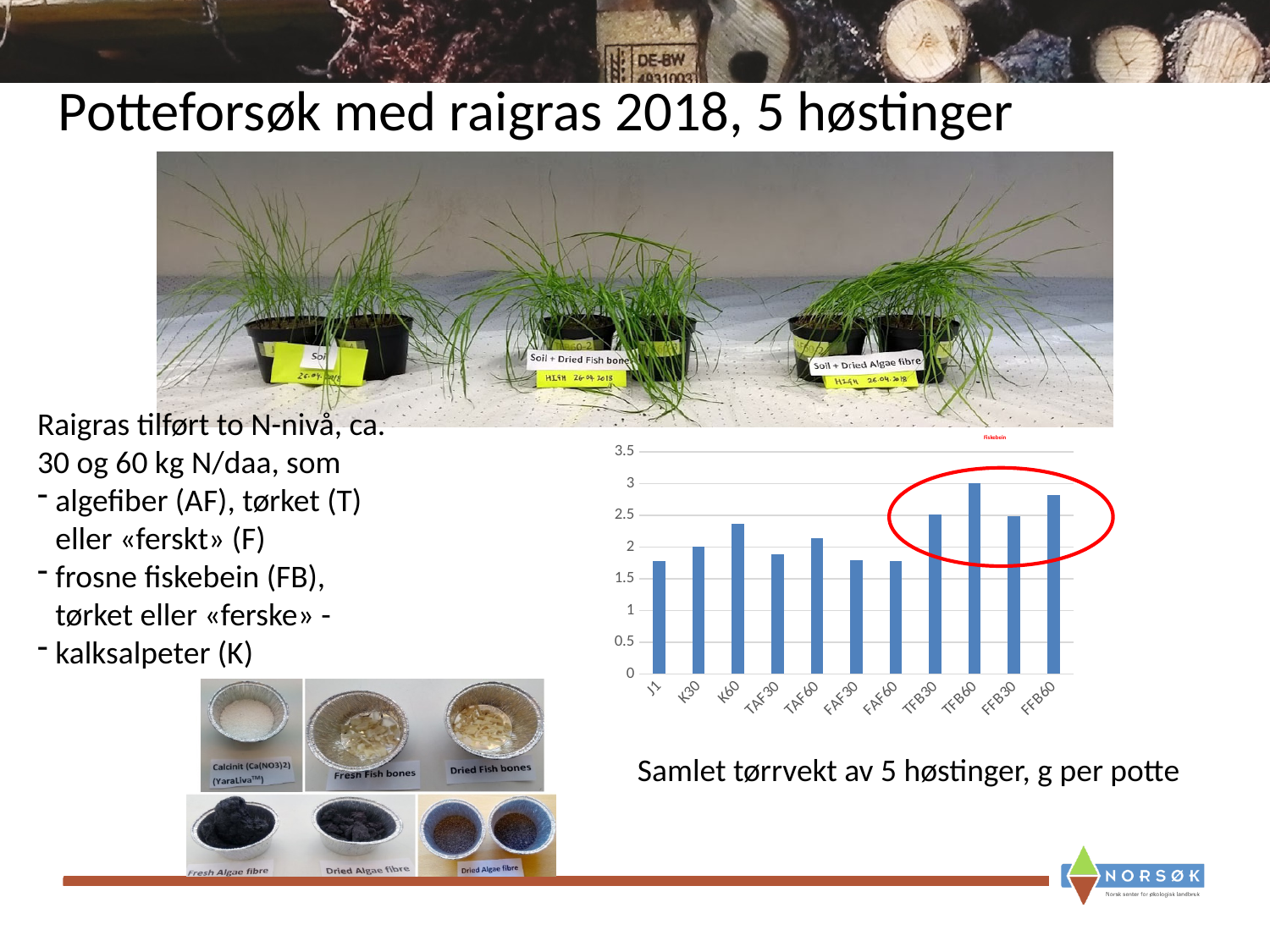
Which is larger, the value for TFB60 or the value for FFB60? TFB60 Is the value for K60 greater or less than 2? greater Which category has the highest bar in the chart? TFB60 Is the value for J1 greater or less than 2? less Is the value for TAF30 greater or less than 2? less What kind of chart is shown on the slide? bar chart Which is larger, the value for K60 or the value for K30? K60 According to the caption below the chart, what do the bars represent? Samlet tørrvekt av 5 høstinger, g per potte How many categories are shown on the x axis of the bar chart? 11